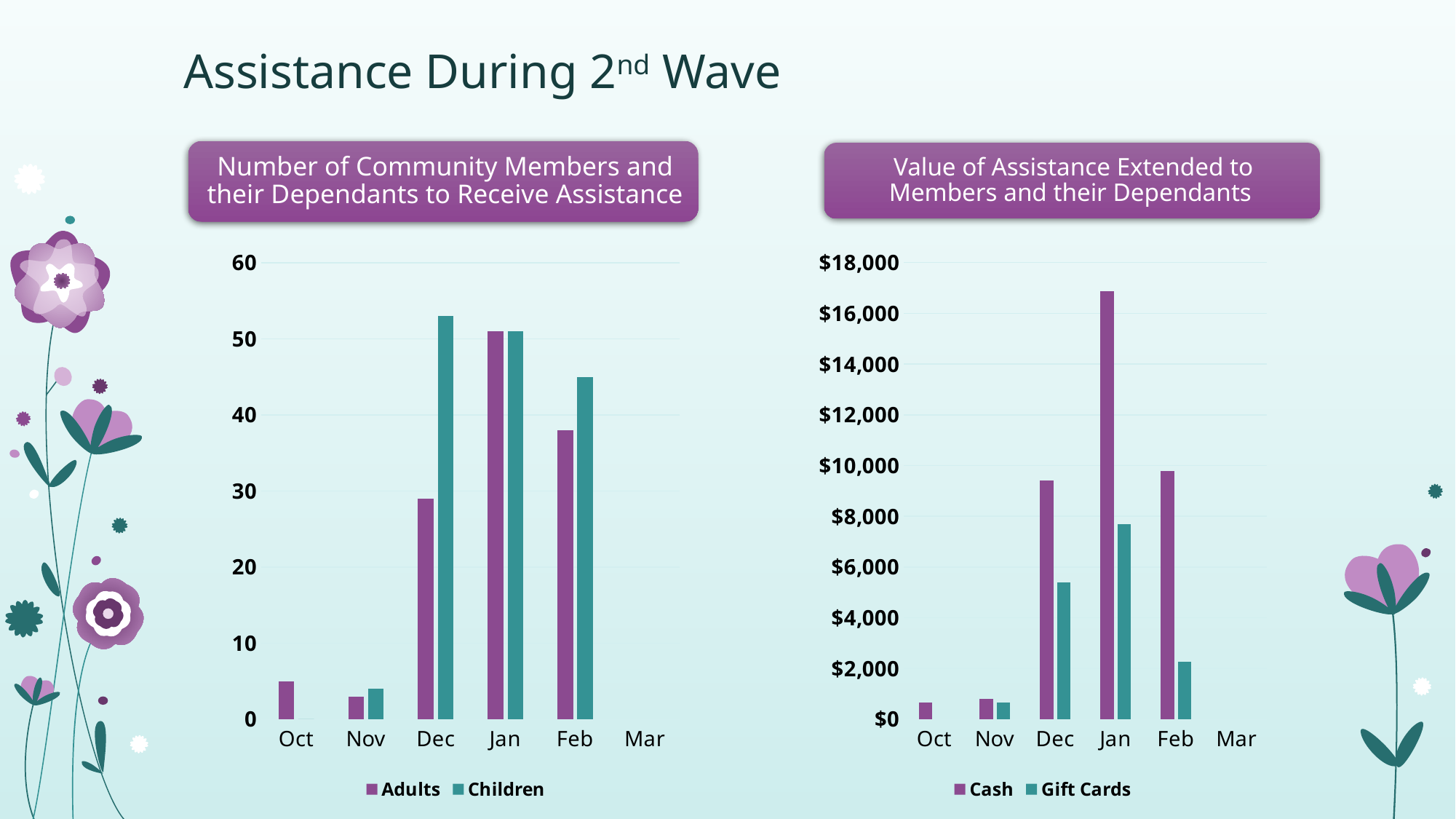
In the 'Value of Assistance Extended to Members and their Dependants' chart, is the Gift Cards value for Dec greater or less than $6,000? less In the 'Value of Assistance Extended to Members and their Dependants' chart, which is larger for Feb: Cash or Gift Cards? Cash What are the two legend entries of the 'Number of Community Members and their Dependants to Receive Assistance' chart? Adults and Children In the 'Value of Assistance Extended to Members and their Dependants' chart, which month has the highest Cash value? Jan How many series does the legend of the 'Value of Assistance Extended to Members and their Dependants' chart list? 2 How many months are shown on the x axis of the 'Number of Community Members and their Dependants to Receive Assistance' chart? 6 In the 'Number of Community Members and their Dependants to Receive Assistance' chart, which is larger for Feb: Adults or Children? Children In the 'Value of Assistance Extended to Members and their Dependants' chart, is the Cash value for Jan greater or less than $16,000? greater In the 'Number of Community Members and their Dependants to Receive Assistance' chart, which month has the highest Children value? Dec In the 'Value of Assistance Extended to Members and their Dependants' chart, does the Cash value rise or fall from Dec to Jan? rise What kind of chart is the 'Number of Community Members and their Dependants to Receive Assistance' chart? bar chart